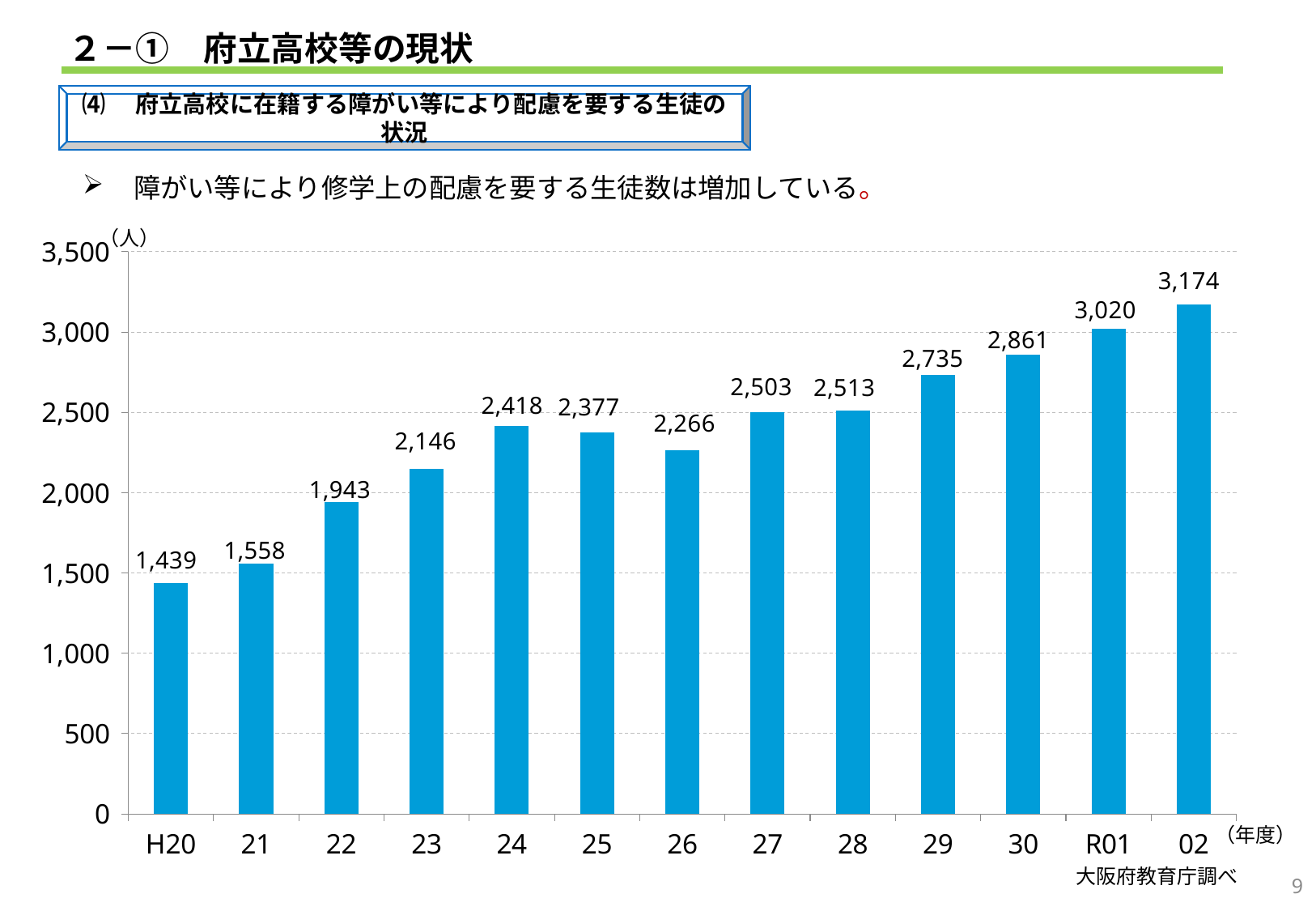
Which is larger, the value for 25 or the value for 26? 25 How many years are shown on the x axis? 13 Which year has the highest value? 02 What is the value for 26? 2,266 What kind of chart is this? bar chart Is the value for 30 greater or less than 3,000? less What is the value for H20? 1,439 What is the value for R01? 3,020 Which year has the lowest value? H20 What unit is shown at the top of the y axis? （人） What is the difference between the values for 24 and 25? 41 What is the difference between the values for 02 and H20? 1,735